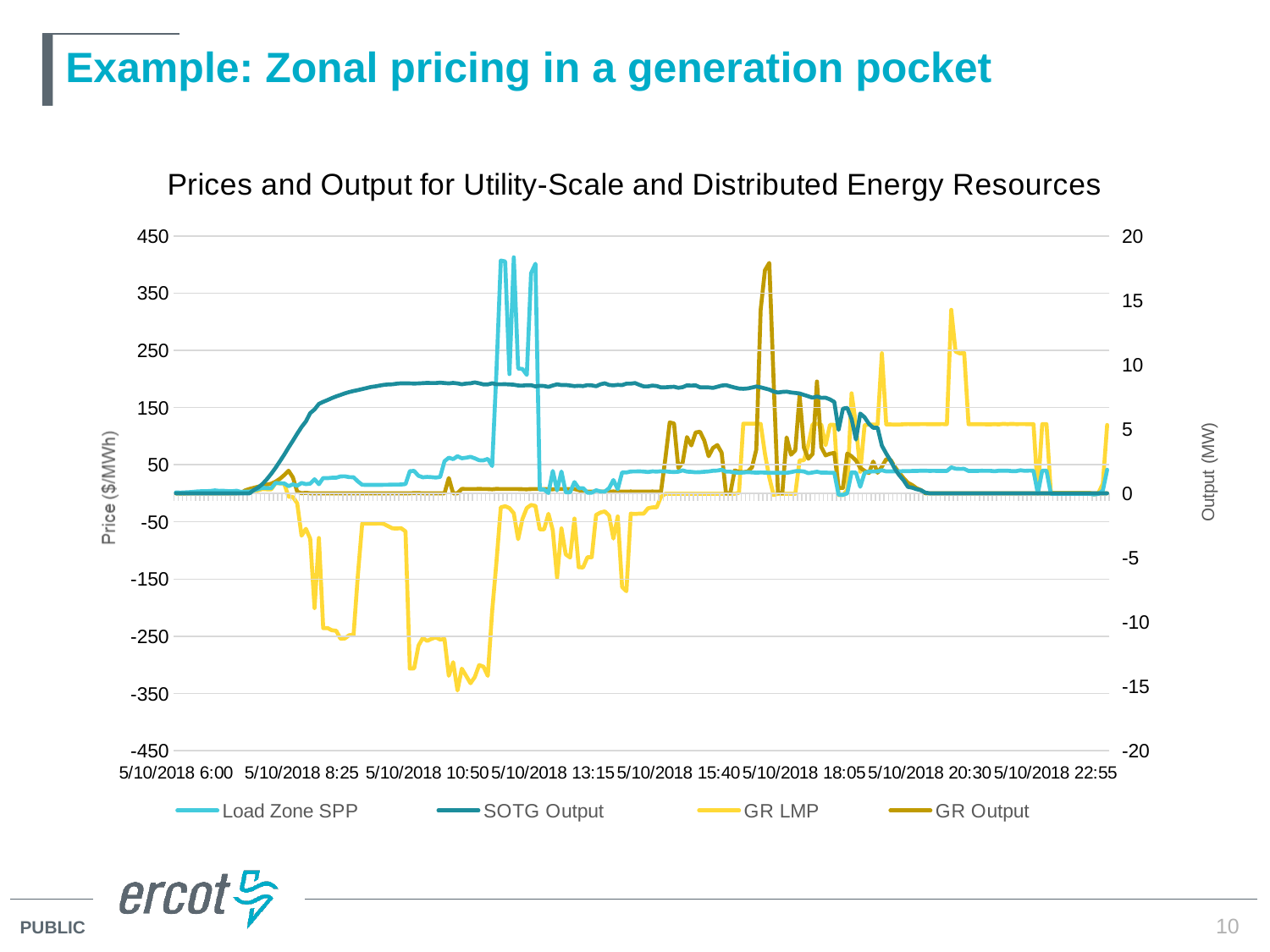
Which series reaches a higher peak on the price axis, Load Zone SPP or GR LMP? Load Zone SPP What kind of chart is shown on the slide? Line chart Does the SOTG Output series rise or fall between 5/10/2018 18:05 and 5/10/2018 20:30? fall Is the peak value of the Load Zone SPP series greater or less than 350 $/MWh? greater Is the plateau level of the SOTG Output series during the middle of the day greater or less than 5 MW? greater Is the peak value of the GR Output series greater or less than 15 MW? greater How many series does the legend list? 4 What is the title of the chart? Prices and Output for Utility-Scale and Distributed Energy Resources What is the label of the left vertical axis? Price ($/MWh) Does the SOTG Output series rise or fall between 5/10/2018 8:25 and 5/10/2018 10:50? rise